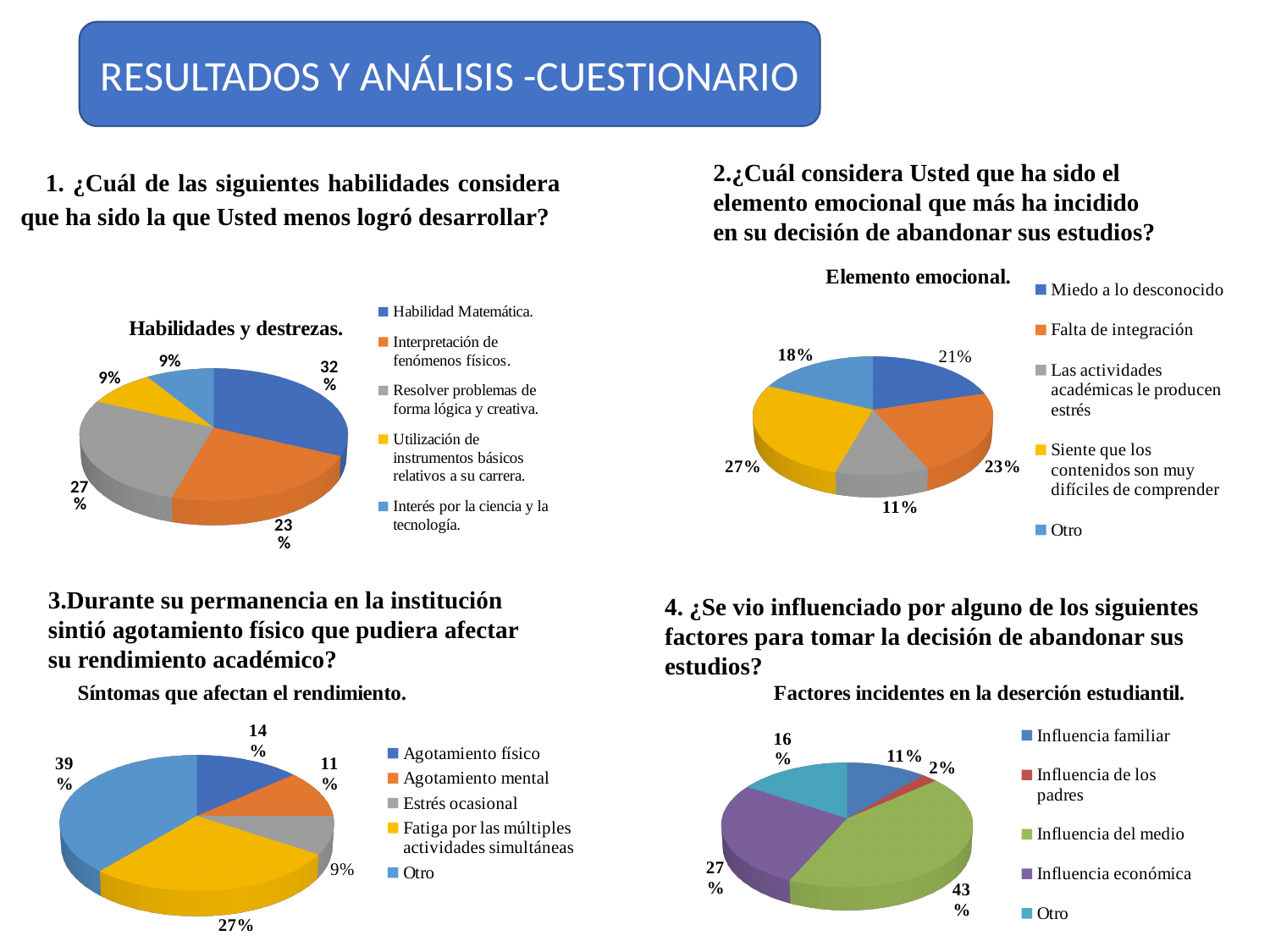
In the 'Síntomas que afectan el rendimiento.' chart, what share does 'Otro' have? 39% What type of chart is 'Síntomas que afectan el rendimiento.'? Pie chart In the 'Elemento emocional.' chart, which is larger: 'Miedo a lo desconocido' or 'Falta de integración'? Falta de integración In the 'Elemento emocional.' chart, which category has the smallest share? Las actividades académicas le producen estrés In the 'Factores incidentes en la deserción estudiantil.' chart, what share does 'Influencia de los padres' have? 2% In the 'Elemento emocional.' chart, what share does 'Siente que los contenidos son muy difíciles de comprender' have? 27% In the 'Habilidades y destrezas.' chart, what is the difference between 'Resolver problemas de forma lógica y creativa.' and 'Interpretación de fenómenos físicos.'? 4% In the 'Factores incidentes en la deserción estudiantil.' chart, which category has the largest share? Influencia del medio In the 'Síntomas que afectan el rendimiento.' chart, what is the difference between 'Fatiga por las múltiples actividades simultáneas' and 'Agotamiento físico'? 13% How many categories does the legend of the 'Factores incidentes en la deserción estudiantil.' chart list? 5 In the 'Habilidades y destrezas.' chart, what share does 'Habilidad Matemática.' have? 32% In the 'Habilidades y destrezas.' chart, which category has the largest share? Habilidad Matemática.